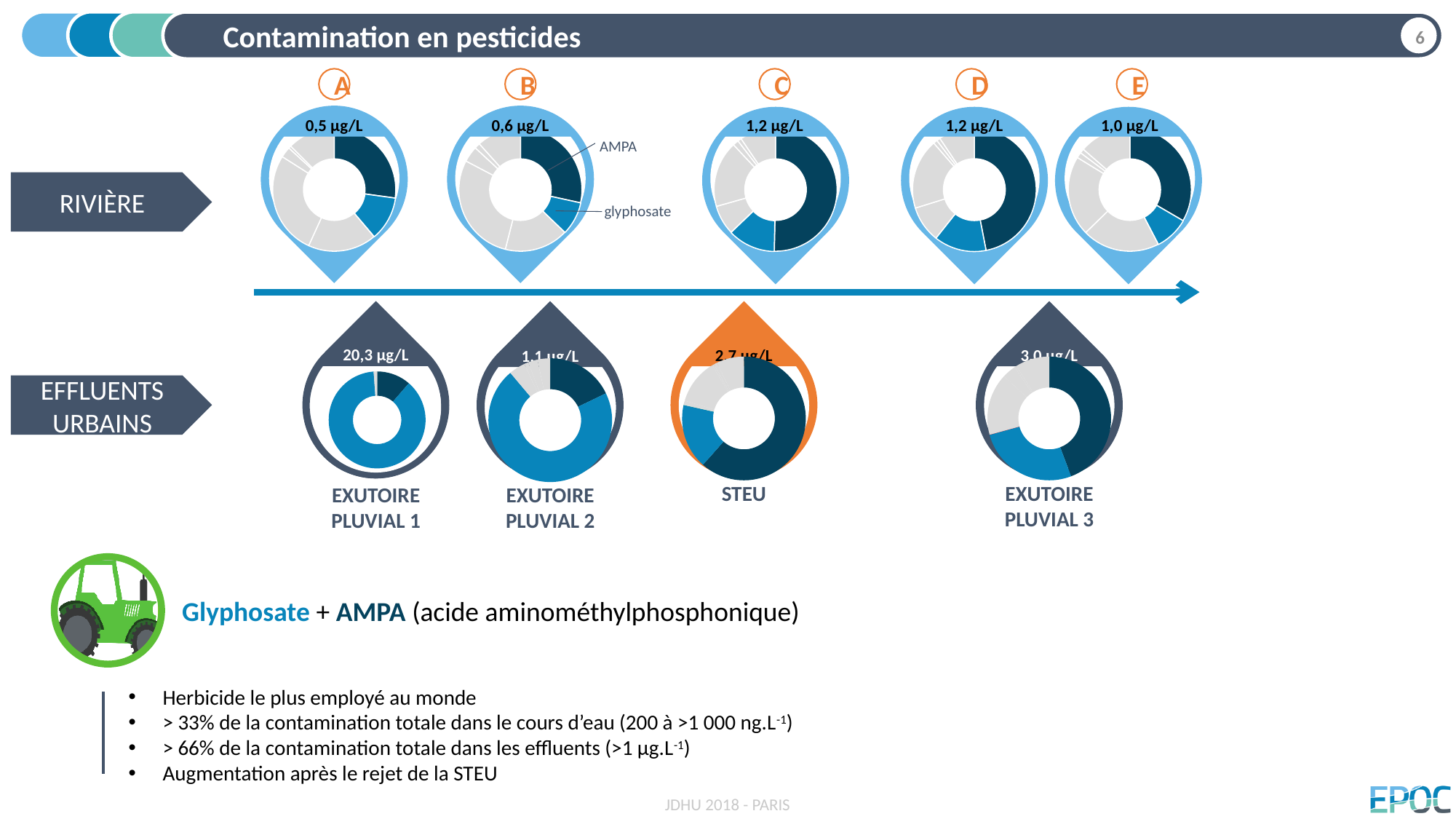
Among the urban effluent charts, which has the lowest concentration? EXUTOIRE PLUVIAL 2 What total pesticide concentration is shown for river site A? 0,5 µg/L Which has the larger concentration, STEU or EXUTOIRE PLUVIAL 3? EXUTOIRE PLUVIAL 3 What is the difference in concentration between EXUTOIRE PLUVIAL 1 and EXUTOIRE PLUVIAL 3? 17,3 µg/L What concentration is shown for the EXUTOIRE PLUVIAL 3 effluent chart? 3,0 µg/L How many river sampling sites are shown in the RIVIÈRE row? 5 What concentration is shown for the EXUTOIRE PLUVIAL 1 effluent chart? 20,3 µg/L What kind of chart is used to show the composition at each site? Donut (pie) chart What concentration is shown for the STEU effluent chart? 2,7 µg/L Among the urban effluent charts, which has the highest concentration? EXUTOIRE PLUVIAL 1 Among the river sites A to E, which has the lowest concentration? A What total pesticide concentration is shown for river site C? 1,2 µg/L